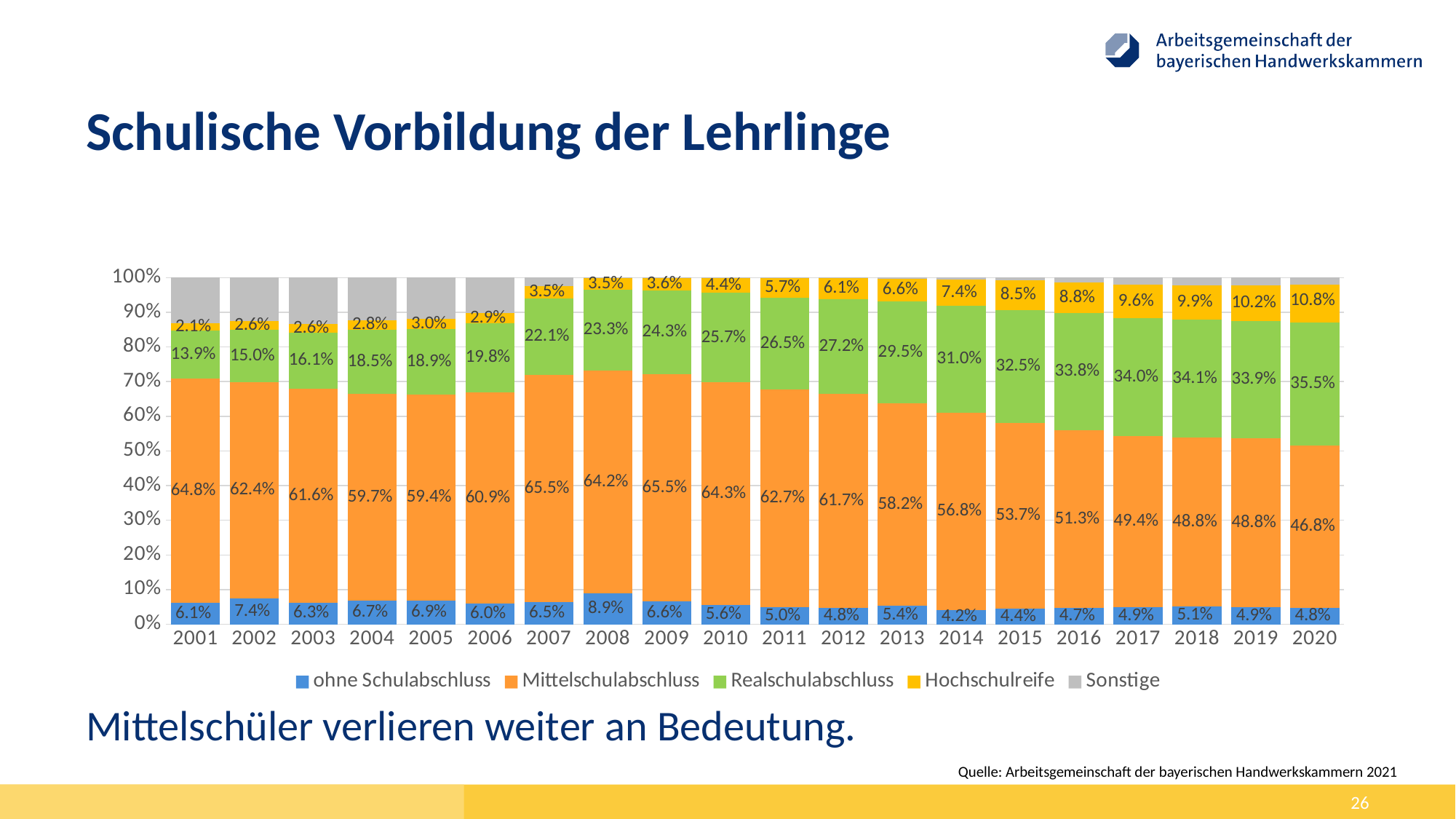
In which year is the share of Hochschulreife the lowest? 2001 In which year is the share of ohne Schulabschluss the highest? 2008 What is the value for Mittelschulabschluss in 2020? 46.8% How many series does the legend list? 5 How many years are shown on the x axis? 20 By how many percentage points did the Mittelschulabschluss share fall from 2001 to 2020? 18.0 percentage points Which is larger in 2015: the Mittelschulabschluss share in 2015 or in 2016? 2015 What is the value for Realschulabschluss in 2001? 13.9% In which year is the share of Realschulabschluss the highest? 2020 What is the value for Hochschulreife in 2020? 10.8% Does the share of Hochschulreife rise or fall from 2001 to 2020? Rise What kind of chart is shown on the slide? Stacked bar chart